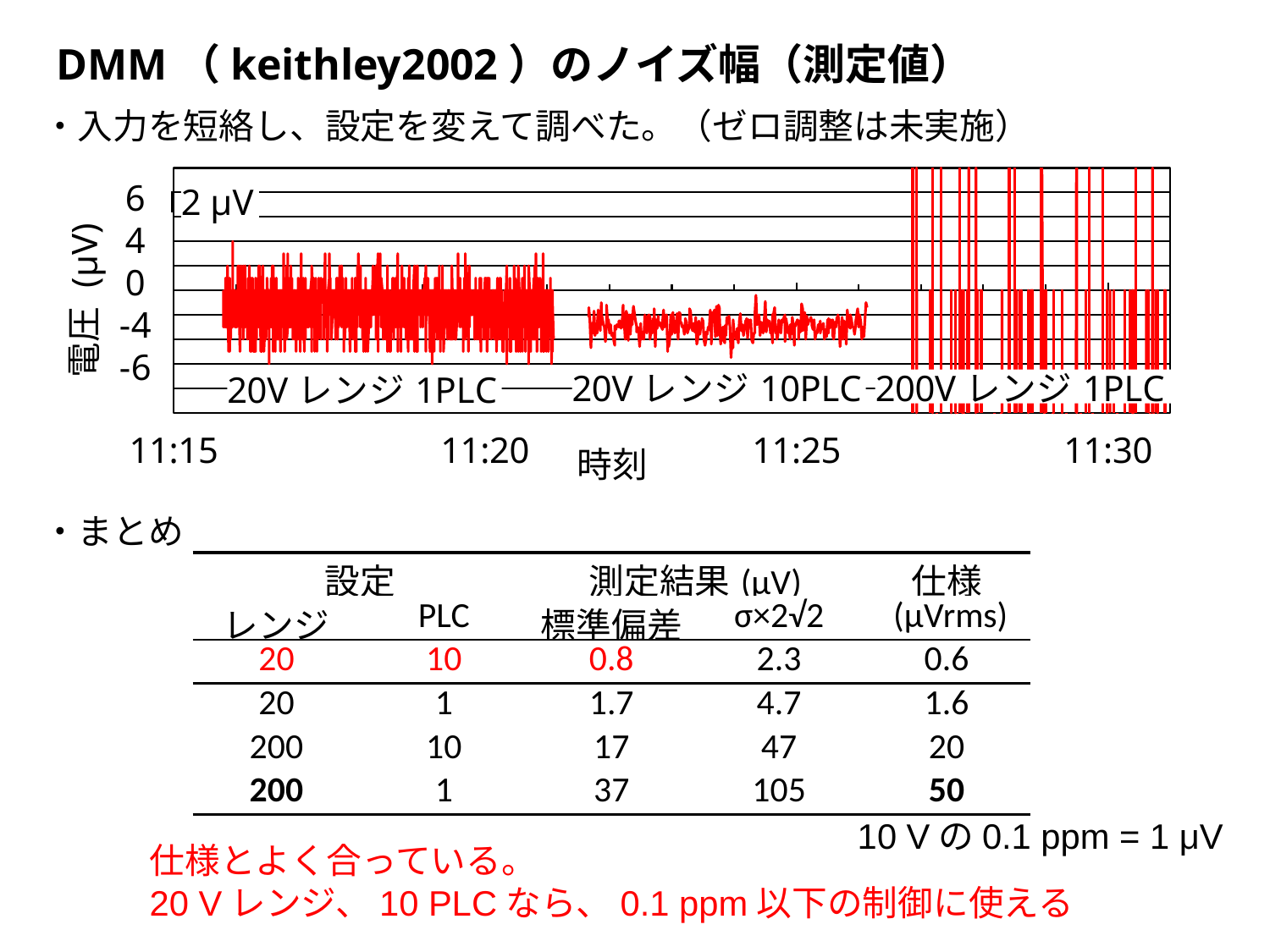
What is the label of the horizontal axis of the chart? 時刻 Which segment has the larger noise amplitude, 20V レンジ 1PLC or 20V レンジ 10PLC? 20V レンジ 1PLC What is the first time tick shown on the horizontal axis? 11:15 How many measurement settings (segments) are labelled on the chart? 3 What is the label of the vertical axis of the chart? 電圧 (µV) Which labelled segment of the chart shows the largest noise amplitude? 200V レンジ 1PLC Which labelled segment of the chart shows the smallest noise amplitude? 20V レンジ 10PLC Which segment appears first (leftmost) along the time axis? 20V レンジ 1PLC Does the 200V レンジ 1PLC segment exceed the 6 µV axis limit? yes Does the 20V レンジ 10PLC segment stay within the -6 to 6 µV axis range? yes What kind of chart is shown on the slide? line chart What is the last time tick shown on the horizontal axis? 11:30